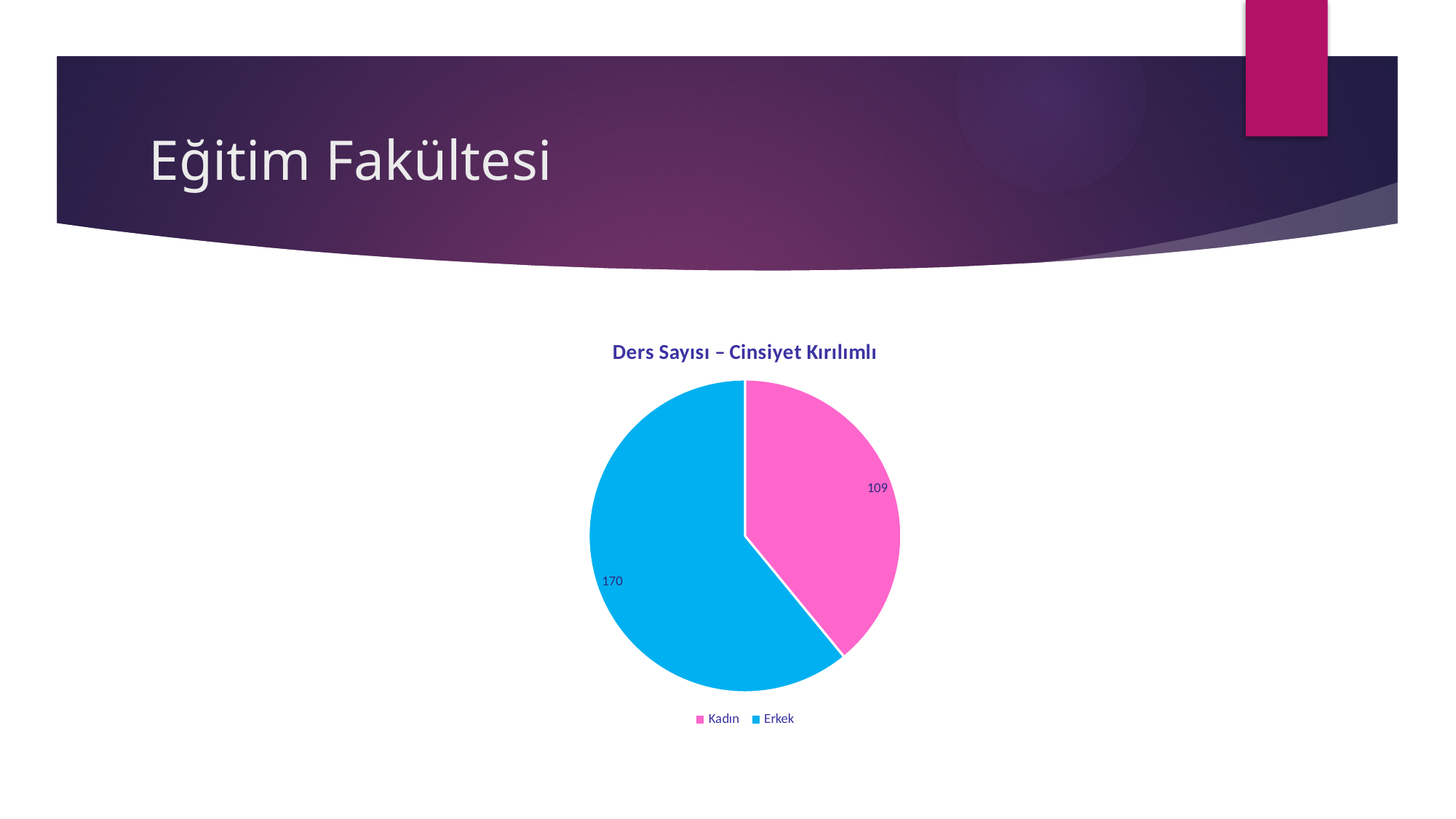
What share of the pie does the Kadın slice represent, to one decimal place? 39.1% What is the difference between the Erkek and Kadın values? 61 Which is larger, the value for Kadın or the value for Erkek? Erkek What is the title of the chart? Ders Sayısı – Cinsiyet Kırılımlı Which colour represents Erkek in the pie chart? Blue What is the value for Erkek in the pie chart? 170 What is the value for Kadın in the pie chart? 109 How many categories does the pie chart show? 2 What is the total of the two values in the pie chart? 279 What kind of chart is shown on the slide? Pie chart Which category has the smallest slice in the pie chart? Kadın Which category has the largest slice in the pie chart? Erkek